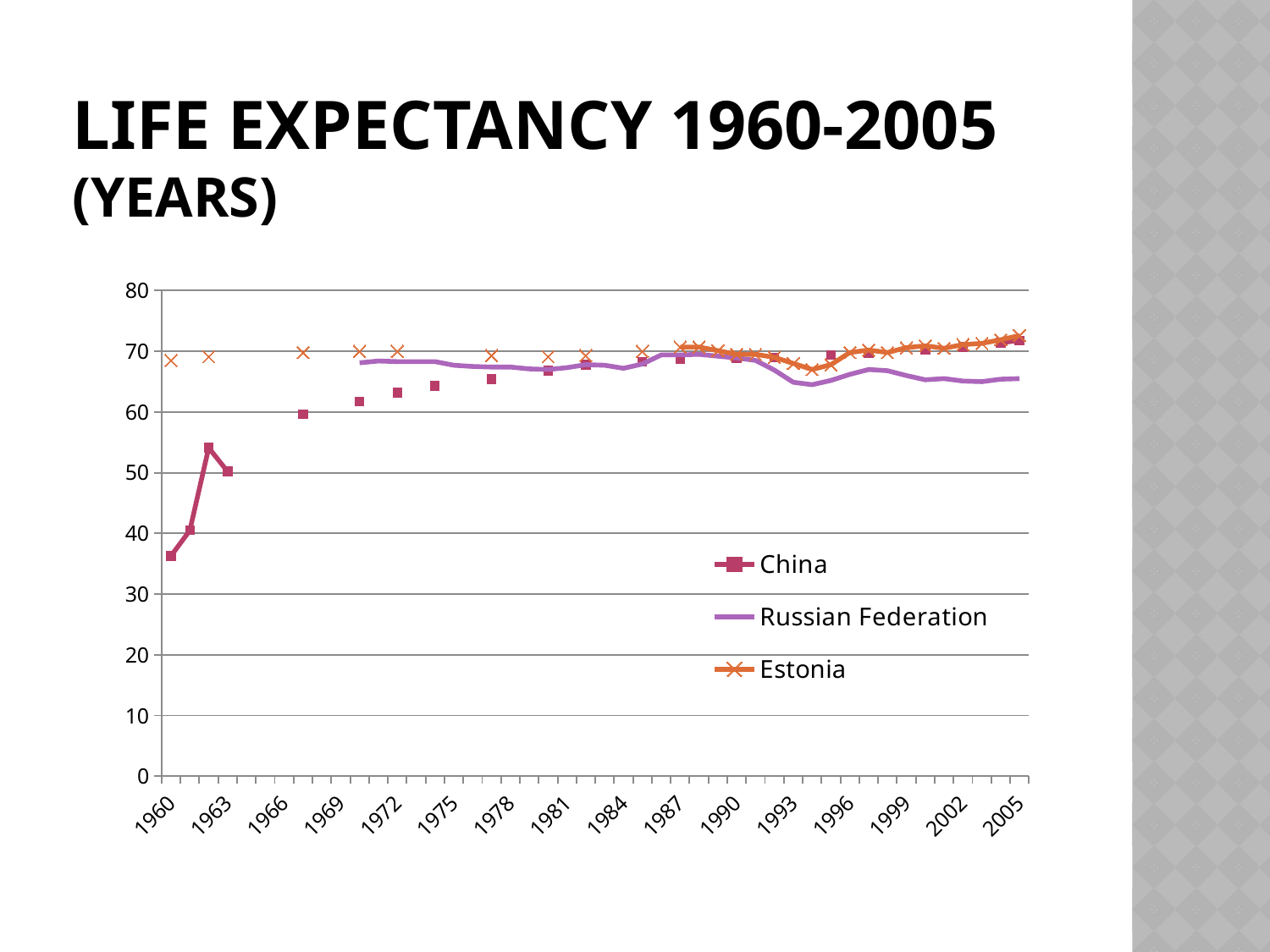
In 1960, which has the higher life expectancy, China or Estonia? Estonia Is the value for China in 1960 greater or less than 40? less What is the title of the chart? Life Expectancy 1960-2005 (Years) Does the life expectancy for China generally rise or fall from 1960 to 2005? rise Is the value for Estonia in 1960 greater or less than 70? less Is the value for Estonia in 2005 greater or less than 70? greater Which three countries are shown in the legend? China, Russian Federation, Estonia What kind of chart is shown on the slide? line chart How many series does the legend list? 3 In 2005, which has the higher life expectancy, Estonia or the Russian Federation? Estonia